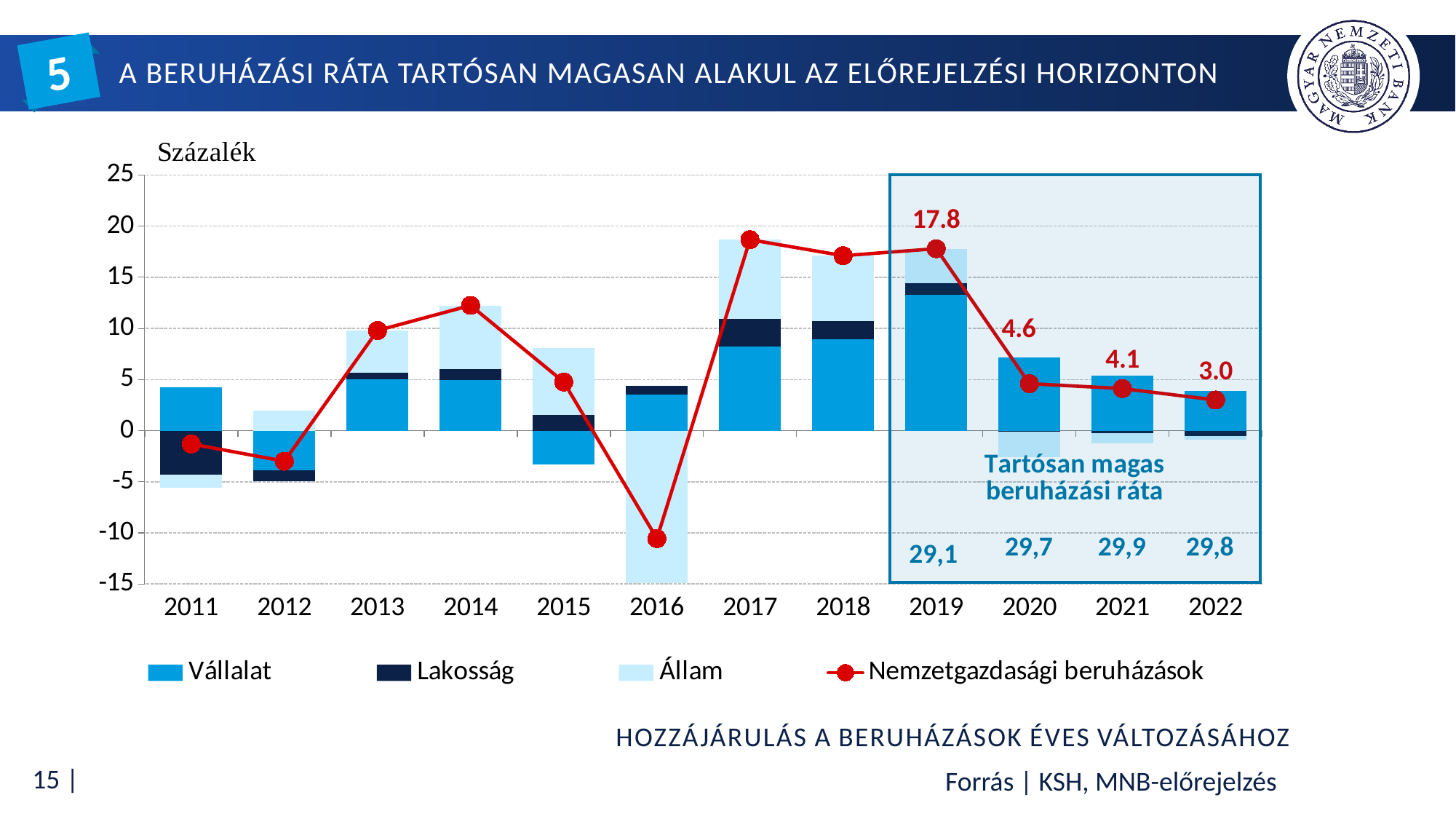
What is the value of Nemzetgazdasági beruházások in 2020? 4.6 What is the difference between the Nemzetgazdasági beruházások values for 2019 and 2020? 13.2 How many years are shown on the x axis? 12 Does the Nemzetgazdasági beruházások line rise or fall from 2019 to 2022? falls Is the Nemzetgazdasági beruházások value for 2014 greater or less than 10? greater What is the value of Nemzetgazdasági beruházások in 2022? 3.0 What unit label is shown above the vertical axis? Százalék What is the value of Nemzetgazdasági beruházások in 2019? 17.8 What kind of chart is this? Stacked bar chart with a line In which year is the Nemzetgazdasági beruházások line at its lowest? 2016 Which is larger, the Nemzetgazdasági beruházások value for 2020 or for 2021? 2020 How many series does the legend list? 4